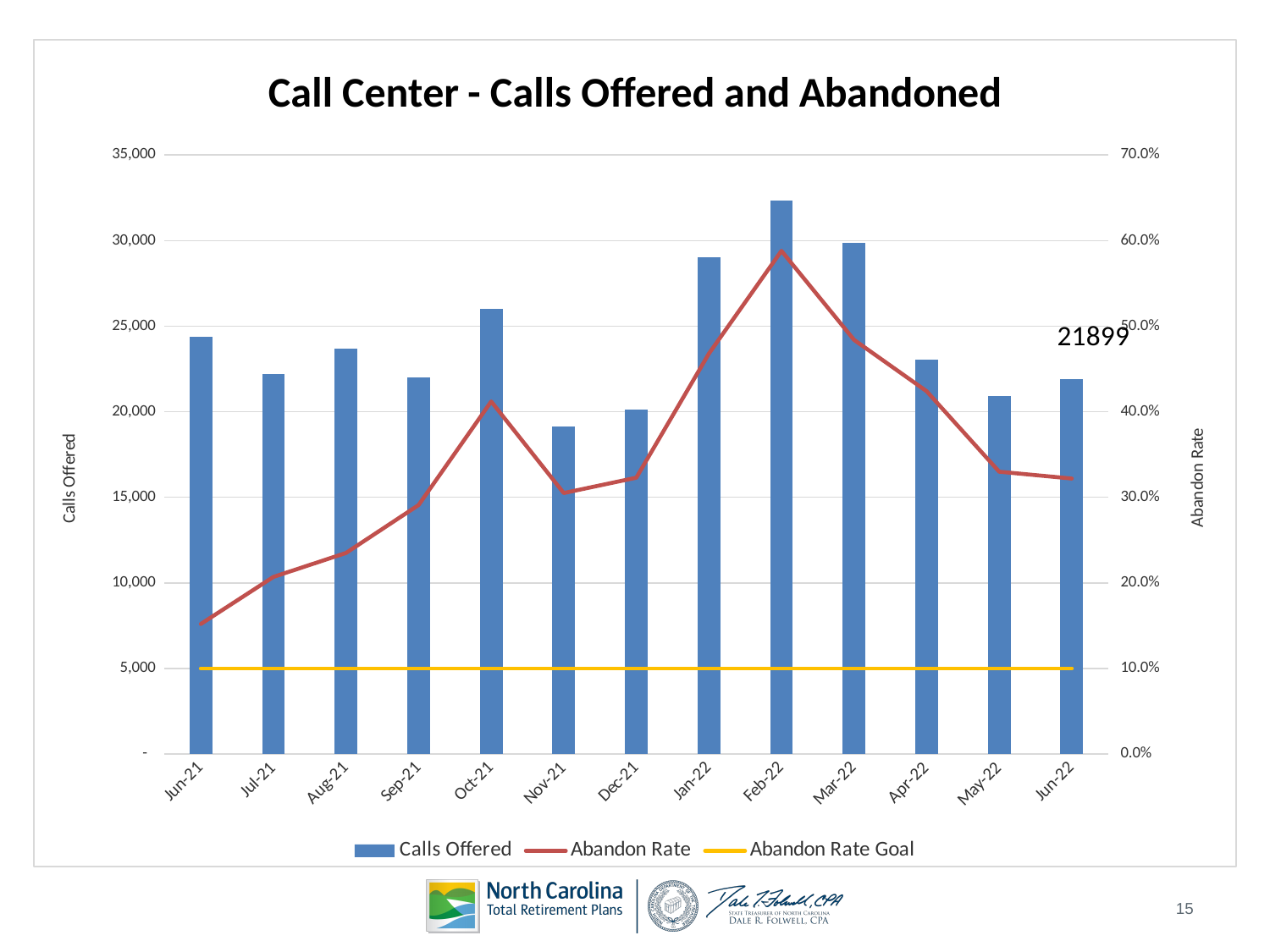
Which month has the highest number of Calls Offered? Feb-22 Which month has the lowest number of Calls Offered? Nov-21 How many months are shown on the x axis? 13 What is the title of the chart? Call Center - Calls Offered and Abandoned Is the value of Calls Offered for Feb-22 greater or less than 30,000? greater What is the value of Calls Offered for Jun-22? 21899 How many series does the legend list? 3 Is the Abandon Rate for Jun-21 greater or less than 20.0%? less Which month has more Calls Offered, Sep-21 or Oct-21? Oct-21 Does the Abandon Rate rise or fall from Feb-22 to Jun-22? fall Which month has the lowest Abandon Rate? Jun-21 Which month has the highest Abandon Rate? Feb-22